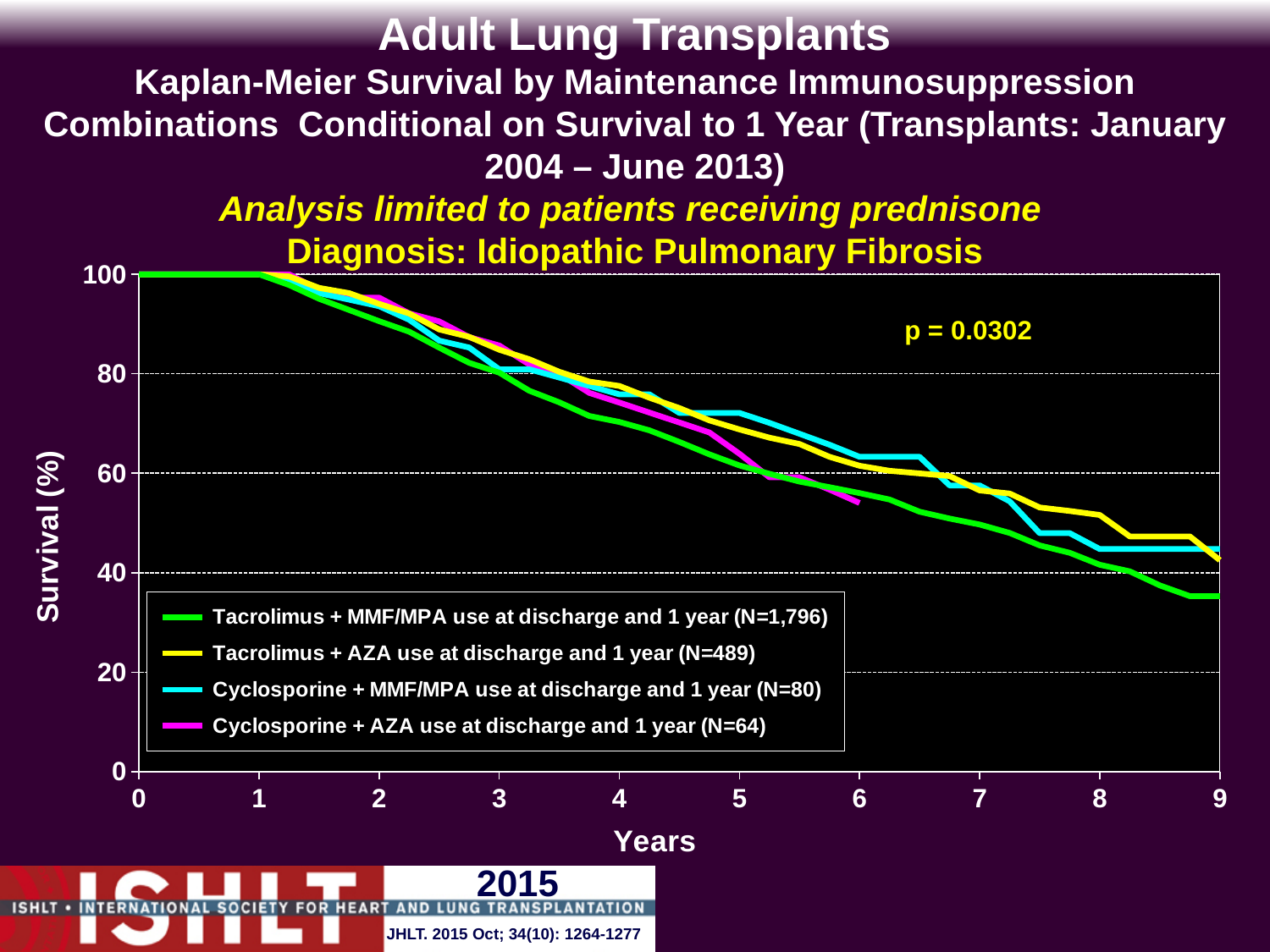
Is the survival value for Cyclosporine + AZA at year 6 greater or less than 60? less At year 9, which series has the lowest survival? Tacrolimus + MMF/MPA use at discharge and 1 year At year 8, which has higher survival: Tacrolimus + AZA or Tacrolimus + MMF/MPA? Tacrolimus + AZA Is the survival value for Tacrolimus + MMF/MPA at year 4 greater or less than 80? less Is the survival value for Cyclosporine + MMF/MPA at year 5 greater or less than 60? greater How many series does the legend list? 4 What kind of chart is shown on the slide? line chart What is the survival (%) for all four series at year 1? 100 Do the survival curves rise or fall as years increase? fall What p-value is printed on the chart? p = 0.0302 What is the N for the Tacrolimus + MMF/MPA series in the legend? N=1,796